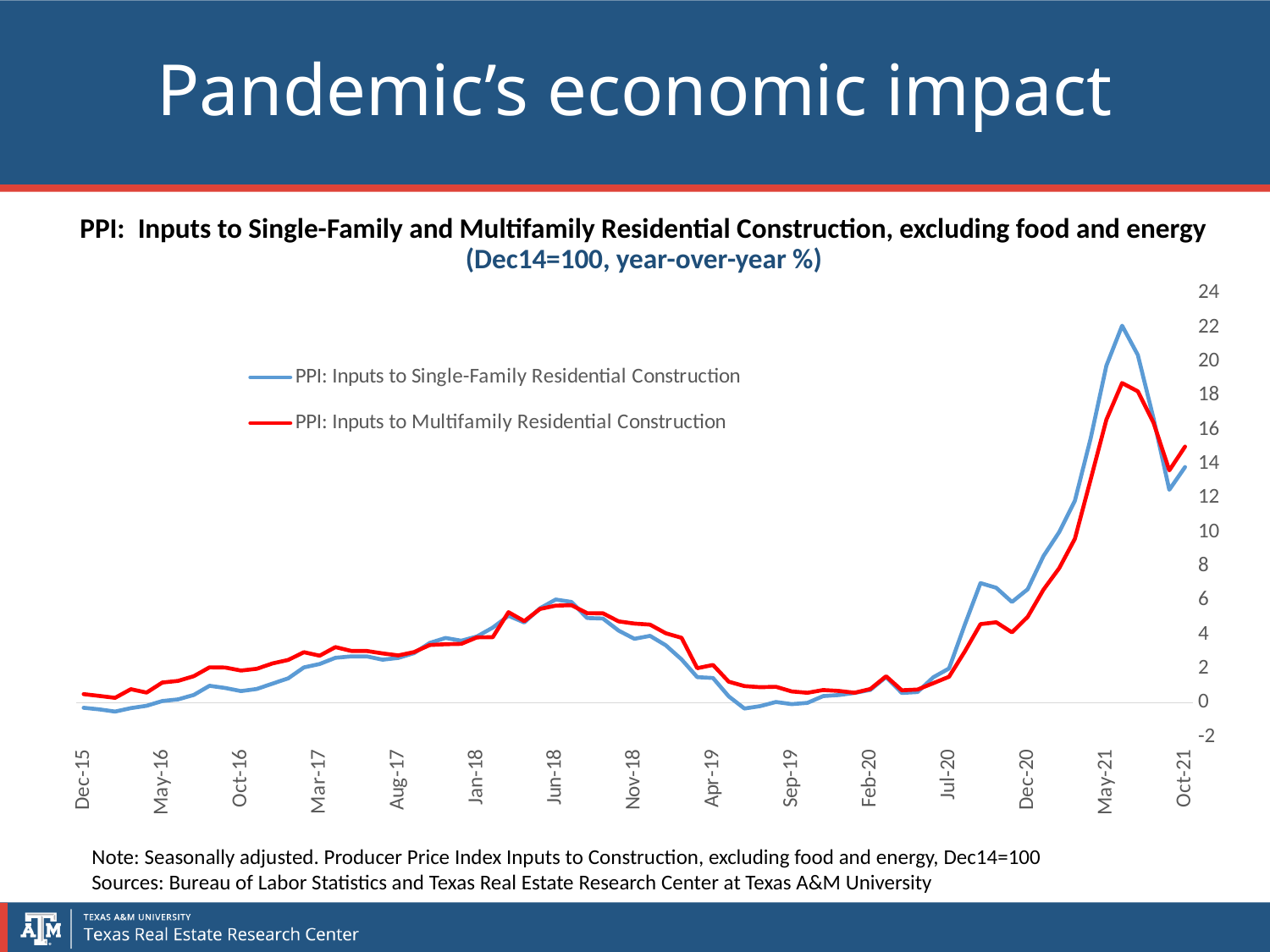
Is the peak value for PPI: Inputs to Single-Family Residential Construction greater or less than 20? greater Is the value for PPI: Inputs to Single-Family Residential Construction at Dec-15 greater or less than 0? less Which series is drawn in red? PPI: Inputs to Multifamily Residential Construction Is the peak value for PPI: Inputs to Multifamily Residential Construction greater or less than 20? less What is the subtitle shown in parentheses under the chart title? (Dec14=100, year-over-year %) Which series reaches the higher peak in 2021? PPI: Inputs to Single-Family Residential Construction Do the values for both series rise or fall between Jul-20 and May-21? rise What kind of chart is shown on the slide? line chart At Oct-21, which series has the higher value, Single-Family or Multifamily? PPI: Inputs to Multifamily Residential Construction How many date labels are shown on the x axis? 15 How many series does the legend list? 2